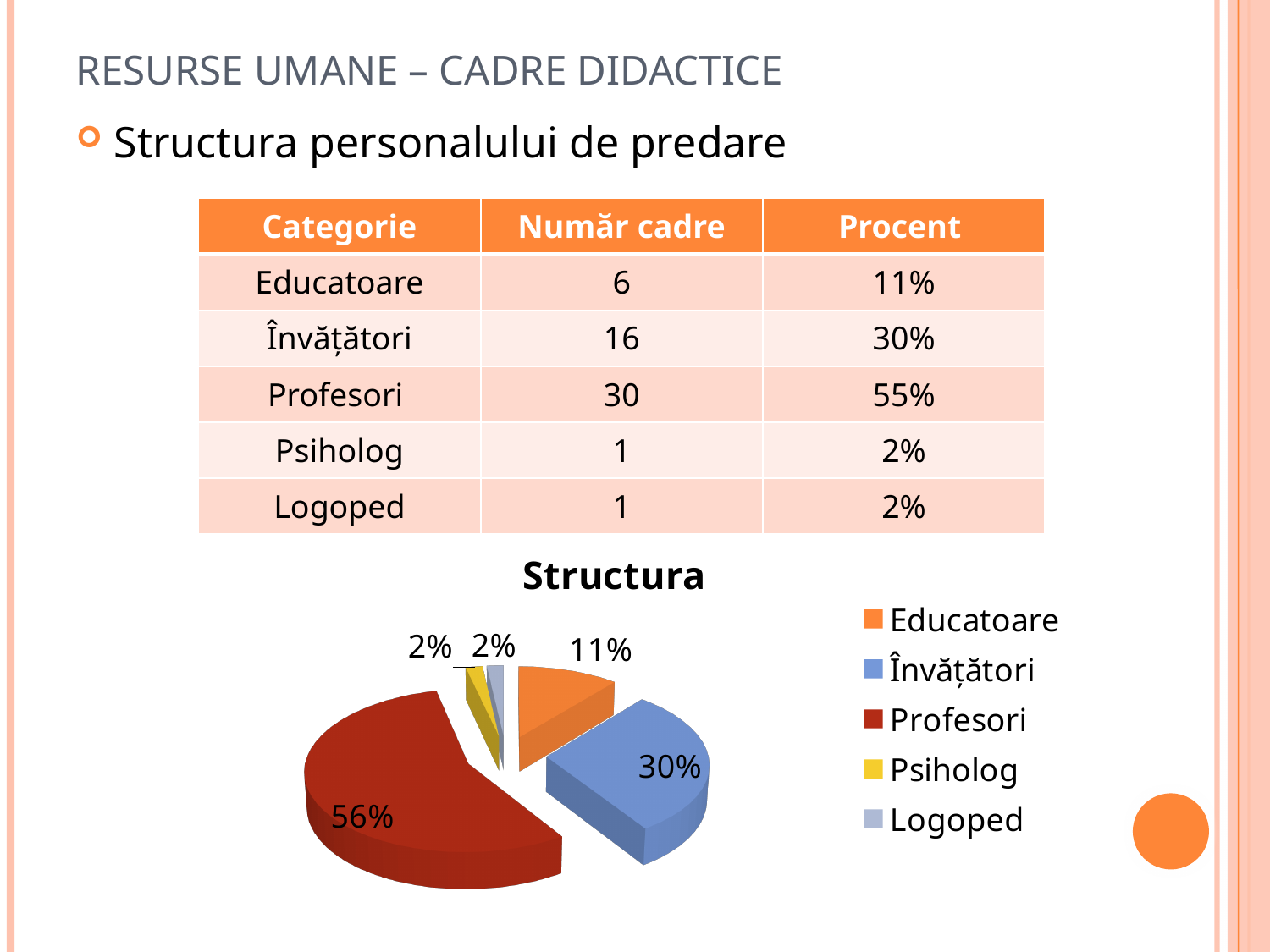
What share of the pie does Învățători have? 30% What share of the pie does Educatoare have? 11% How many entries does the chart legend list? 5 What kind of chart is shown on the slide? pie chart What is the title of the chart? Structura What share of the pie does Profesori have? 56% What is the difference between the Profesori share and the Învățători share in the pie chart? 26% Which category has the largest slice of the pie? Profesori Which colour represents Profesori in the pie chart? dark red How many slices does the pie chart have? 5 Which is larger in the pie chart, Învățători or Educatoare? Învățători